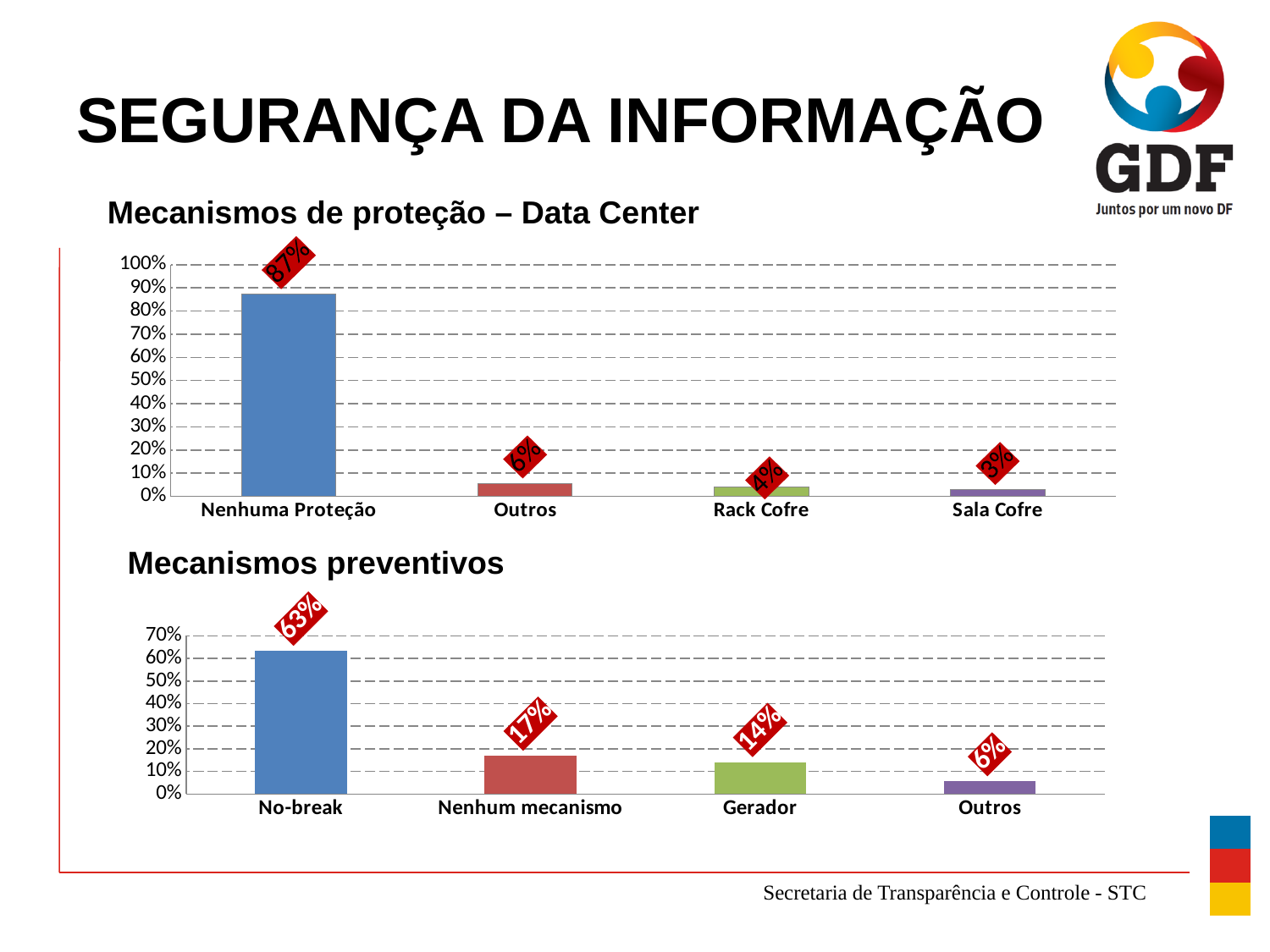
In the 'Mecanismos preventivos' chart, what is the difference between No-break and Nenhum mecanismo? 46% In the 'Mecanismos preventivos' chart, which category has the highest value? No-break In the 'Mecanismos de proteção – Data Center' chart, which category has the lowest value? Sala Cofre What kind of chart is the 'Mecanismos preventivos' chart? Bar chart In the 'Mecanismos de proteção – Data Center' chart, what is the value for Nenhuma Proteção? 87% In the 'Mecanismos preventivos' chart, which is larger, Nenhum mecanismo or Gerador? Nenhum mecanismo In the 'Mecanismos de proteção – Data Center' chart, what is the value for Rack Cofre? 4% In the 'Mecanismos de proteção – Data Center' chart, what is the difference between Nenhuma Proteção and Outros? 81% In the 'Mecanismos preventivos' chart, do the values rise or fall from left to right? Fall In the 'Mecanismos de proteção – Data Center' chart, how many categories are shown? 4 In the 'Mecanismos preventivos' chart, what is the value for Gerador? 14% In the 'Mecanismos preventivos' chart, what is the value for No-break? 63%